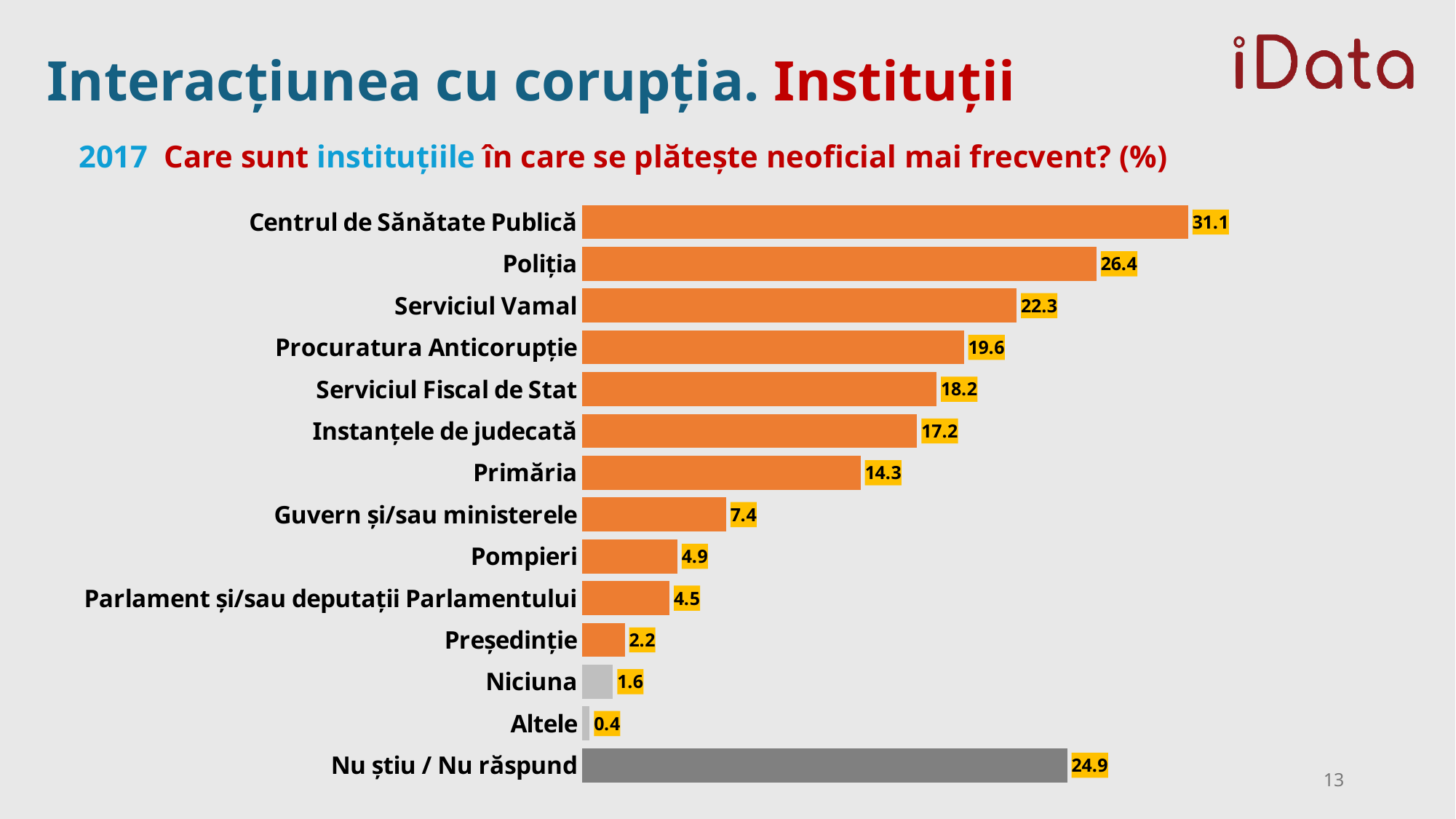
What kind of chart is shown on the slide? Bar chart How many categories are shown in the chart? 14 Which category has the lowest value? Altele What is the difference between the values for Centrul de Sănătate Publică and Poliția? 4.7 What colour is the bar for Nu știu / Nu răspund? Grey What is the value for Nu știu / Nu răspund? 24.9 Which is larger, the value for Poliția or the value for Nu știu / Nu răspund? Poliția What is the value for Centrul de Sănătate Publică? 31.1 What is the difference between the values for Primăria and Guvern și/sau ministerele? 6.9 What is the value for Serviciul Vamal? 22.3 Which category has the highest value? Centrul de Sănătate Publică What is the value for Pompieri? 4.9